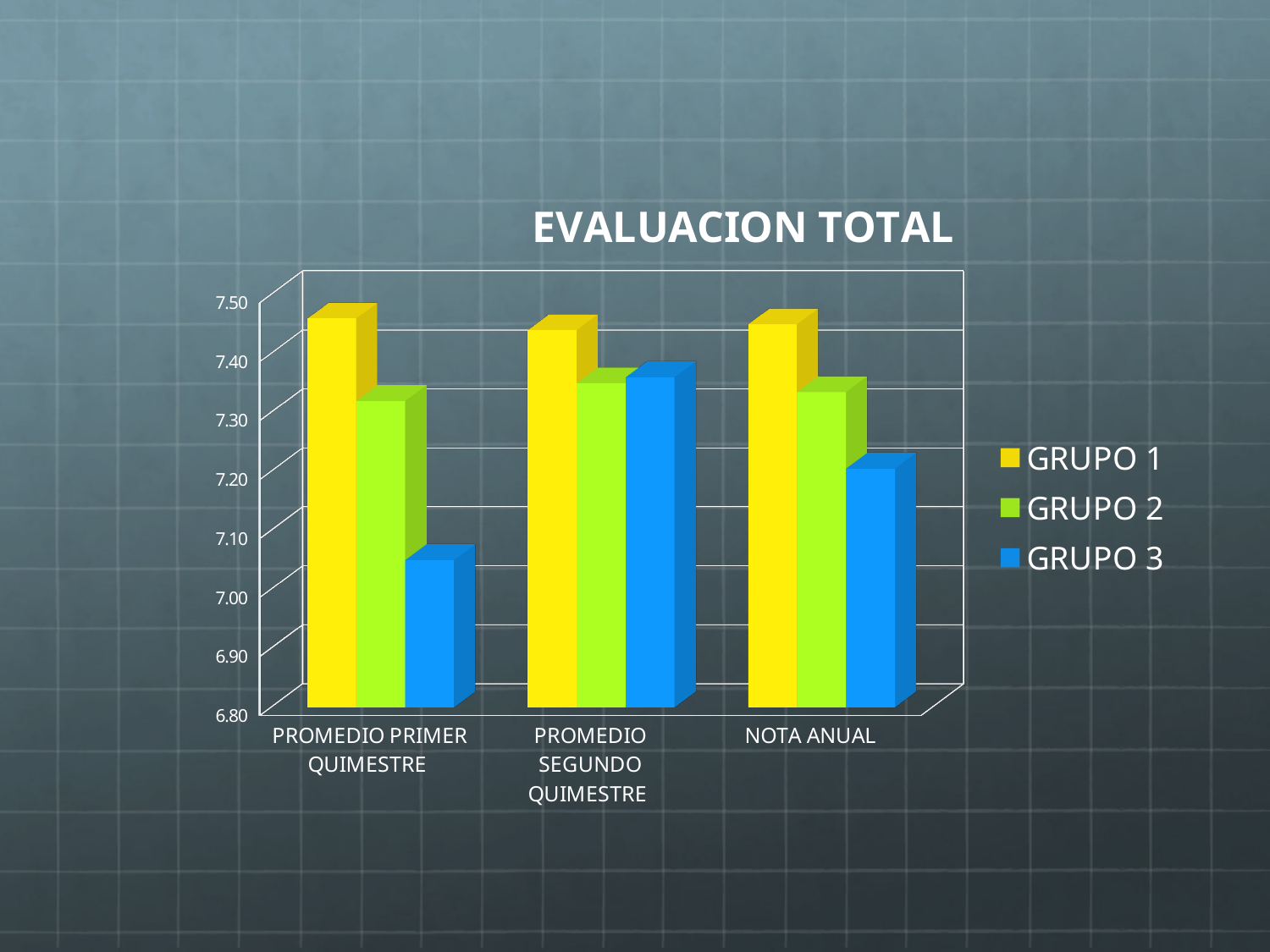
Is the value for GRUPO 3 in NOTA ANUAL greater or less than 7.30? less Is the value for GRUPO 3 in PROMEDIO PRIMER QUIMESTRE greater or less than 7.20? less Which group has the highest value for PROMEDIO PRIMER QUIMESTRE? GRUPO 1 What is the title of the chart? EVALUACION TOTAL For NOTA ANUAL, which is larger: GRUPO 1 or GRUPO 3? GRUPO 1 Is the value for GRUPO 1 in PROMEDIO PRIMER QUIMESTRE greater or less than 7.40? greater What kind of chart is shown on the slide? bar chart Which group has the lowest value for PROMEDIO PRIMER QUIMESTRE? GRUPO 3 How many categories are shown on the x axis? 3 Which group has the lowest value for NOTA ANUAL? GRUPO 3 How many series does the legend list? 3 Which series is shown in blue in the legend? GRUPO 3